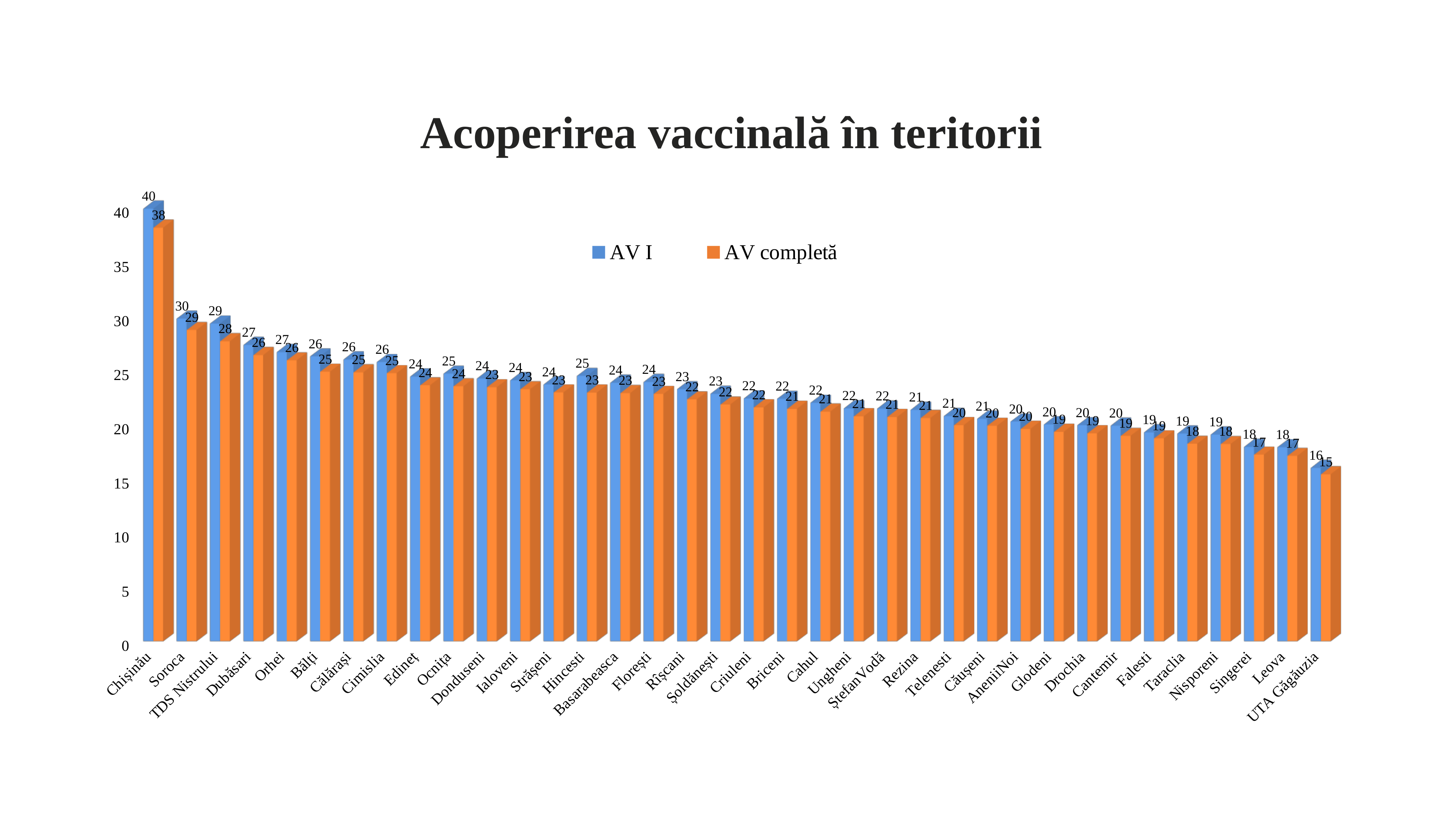
Do the AV I values rise or fall from left to right along the x axis? Fall What is the AV completă value for Soroca? 29 What is the AV I value for Chișinău? 40 What is the difference between the AV I and AV completă values for Chișinău? 2 Which territory has the highest AV I value? Chișinău What is the AV I value for Hincesti? 25 What is the AV completă value for UTA Găgăuzia? 15 Which is larger, the AV I value for Soroca or the AV I value for TDS Nistrului? Soroca How many series does the legend list? 2 How many territories are shown on the x axis? 36 What kind of chart is shown on the slide? Bar chart Which territory has the lowest AV completă value? UTA Găgăuzia